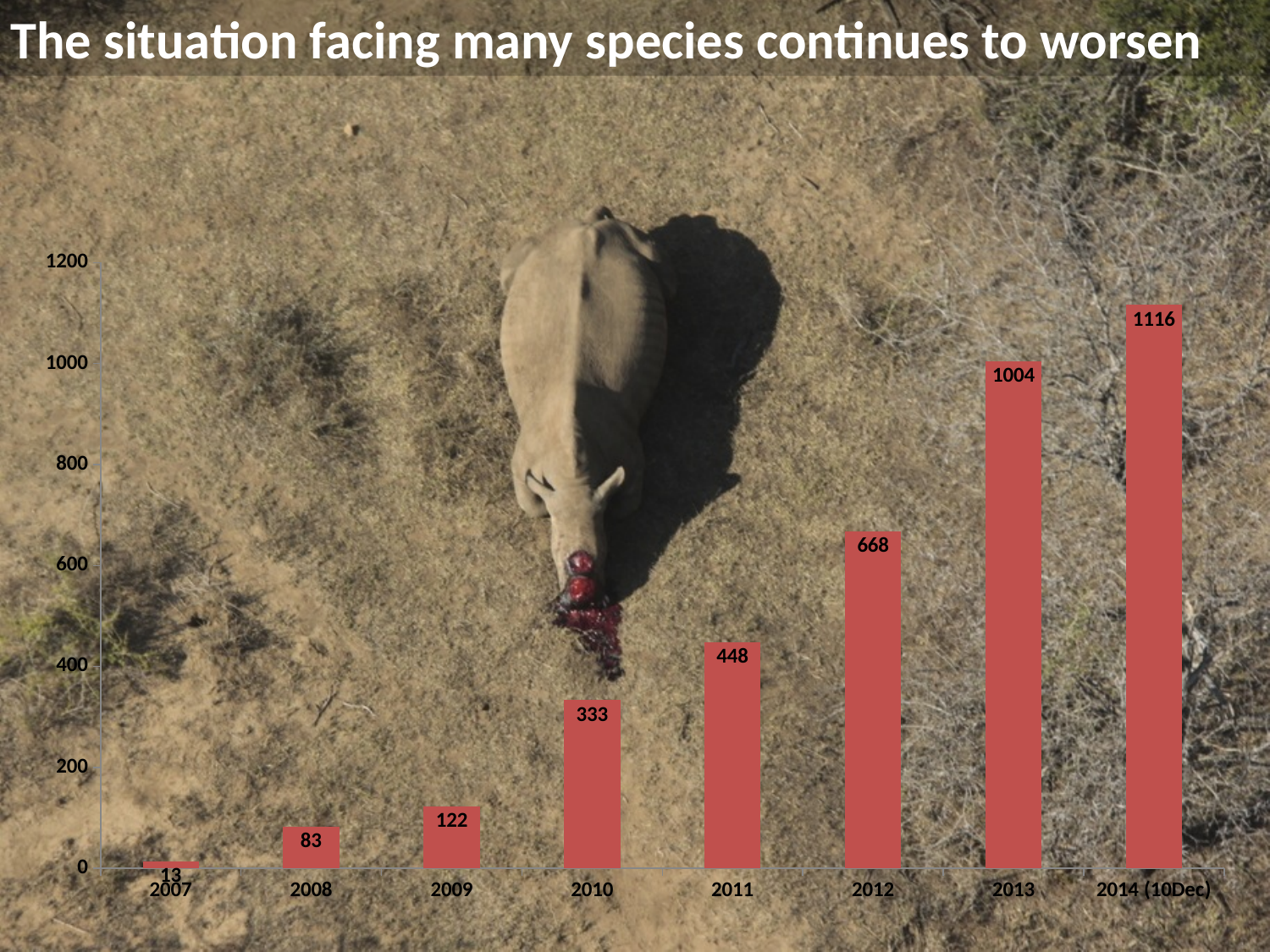
What is the value for 2010? 333 Which year has the lowest value? 2007 How many years are shown on the x axis? 8 What is the value for 2008? 83 What kind of chart is shown on the slide? bar chart Which is larger, the value for 2009 or the value for 2011? 2011 What is the difference between the values for 2012 and 2011? 220 What is the value for 2013? 1004 Is the value for 2012 greater or less than 600? greater What is the title of the slide? The situation facing many species continues to worsen Which year has the highest value? 2014 (10Dec) Do the values rise or fall from 2007 to 2014 (10Dec)? rise